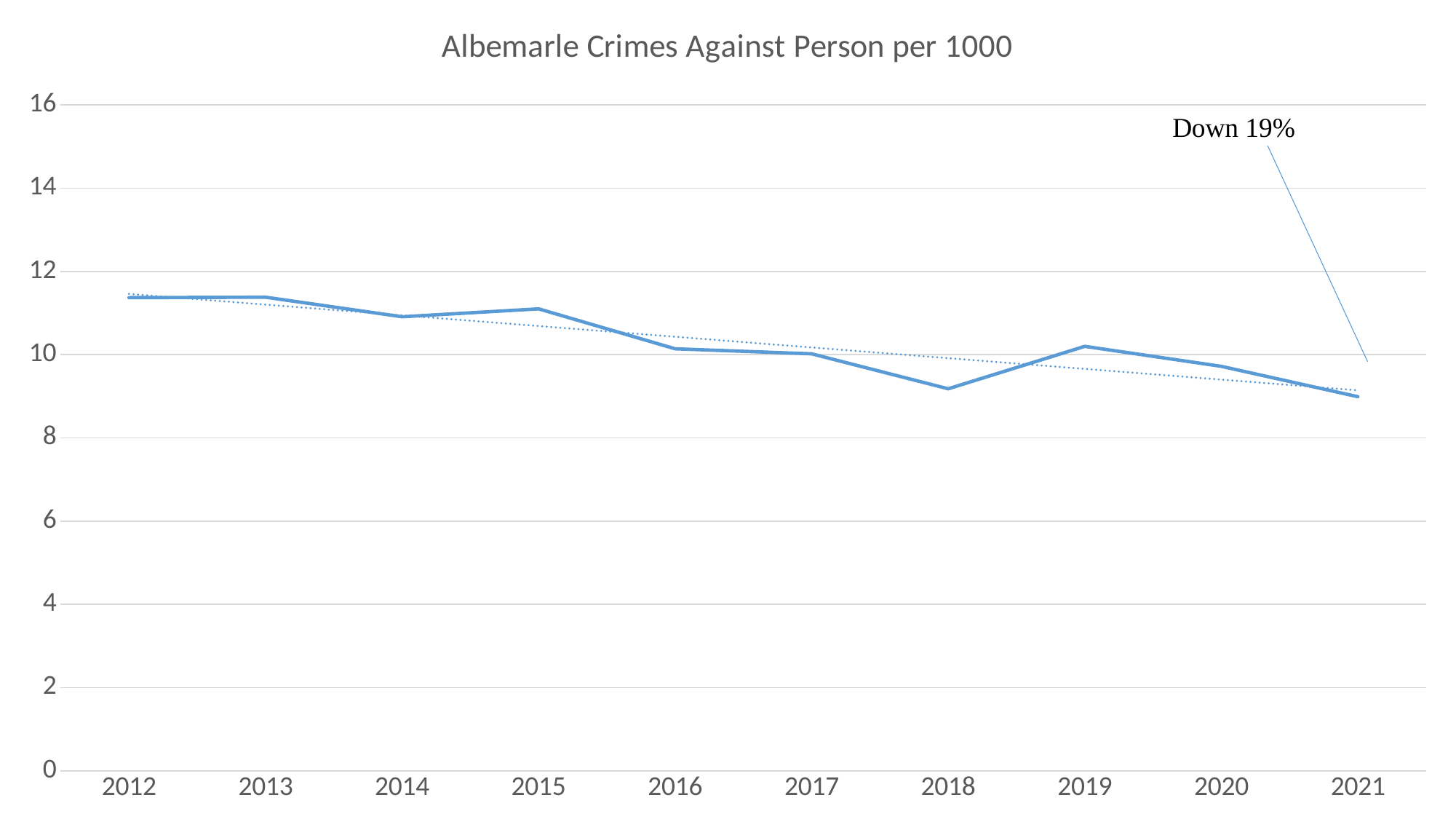
What kind of chart is shown on the slide? line chart Is the value for 2012 greater or less than 10? greater Do the values generally rise or fall from 2012 to 2021? fall Is the value for 2015 greater or less than 12? less What percentage change does the annotation on the chart state? Down 19% Which year has the larger value, 2015 or 2018? 2015 Is the value for 2018 greater or less than 10? less Which year has the larger value, 2012 or 2021? 2012 What is the title of the chart? Albemarle Crimes Against Person per 1000 How many years are plotted along the x axis? 10